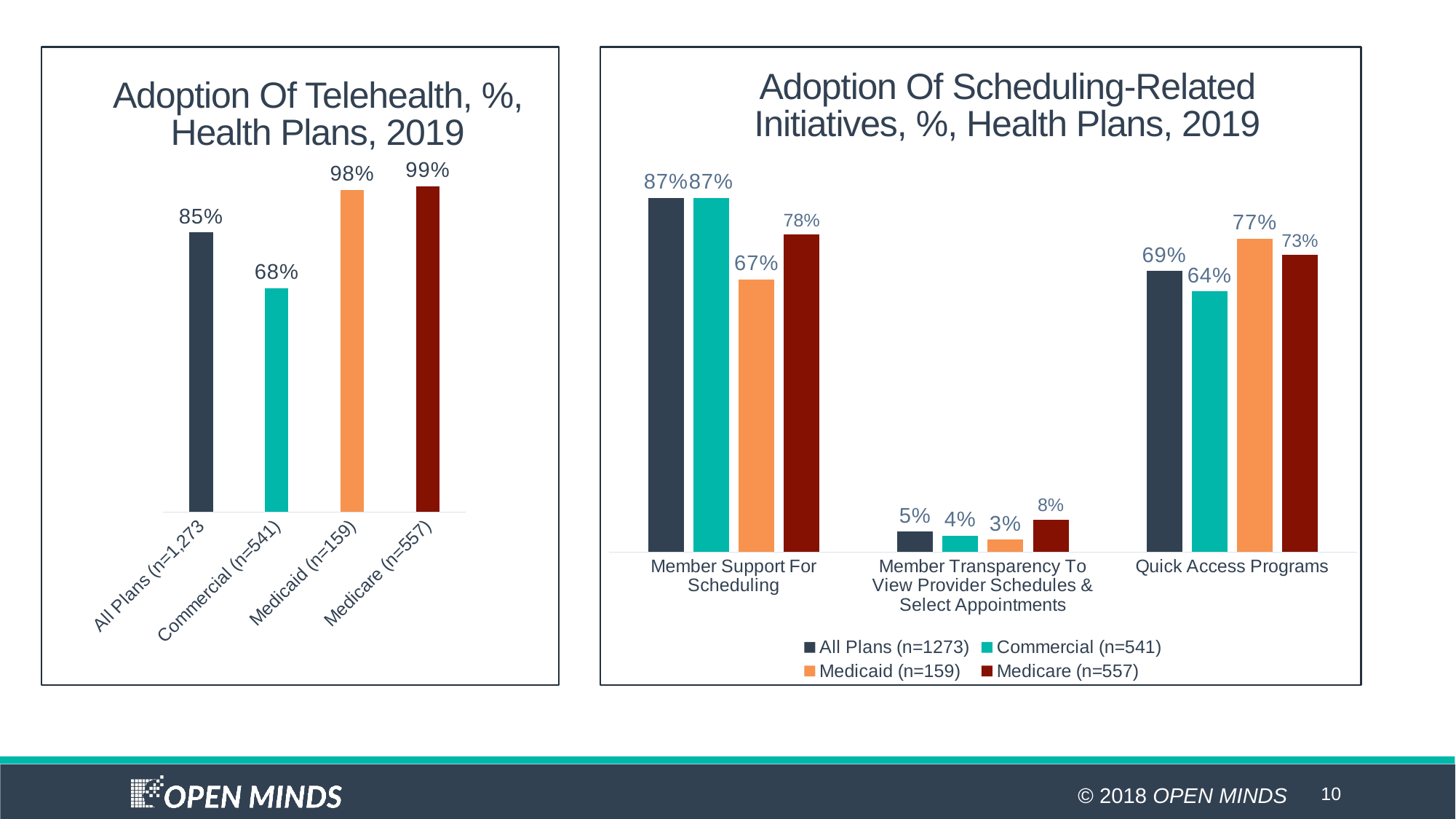
In the 'Adoption Of Scheduling-Related Initiatives' chart, what is the Medicare (n=557) value for Member Transparency To View Provider Schedules & Select Appointments? 8% In the 'Adoption Of Scheduling-Related Initiatives' chart, which series has the lowest value for Member Support For Scheduling? Medicaid (n=159) What kind of chart is the 'Adoption Of Scheduling-Related Initiatives' chart? Bar chart In the 'Adoption Of Scheduling-Related Initiatives' chart, how many series does the legend list? 4 In the 'Adoption Of Scheduling-Related Initiatives' chart, is the All Plans value for Quick Access Programs larger or the Commercial value? All Plans In the 'Adoption Of Scheduling-Related Initiatives' chart, what is the difference between the Medicare and Medicaid values for Member Support For Scheduling? 11% In the 'Adoption Of Telehealth' chart, what is the value for Commercial (n=541)? 68% In the 'Adoption Of Telehealth' chart, what is the difference between the Medicaid (n=159) and All Plans (n=1,273) values? 13% In the 'Adoption Of Scheduling-Related Initiatives' chart, what is the Medicaid (n=159) value for Quick Access Programs? 77% In the 'Adoption Of Telehealth' chart, how many categories are shown? 4 In the 'Adoption Of Telehealth' chart, which category has the lowest value? Commercial (n=541) In the 'Adoption Of Telehealth' chart, which category has the highest value? Medicare (n=557)